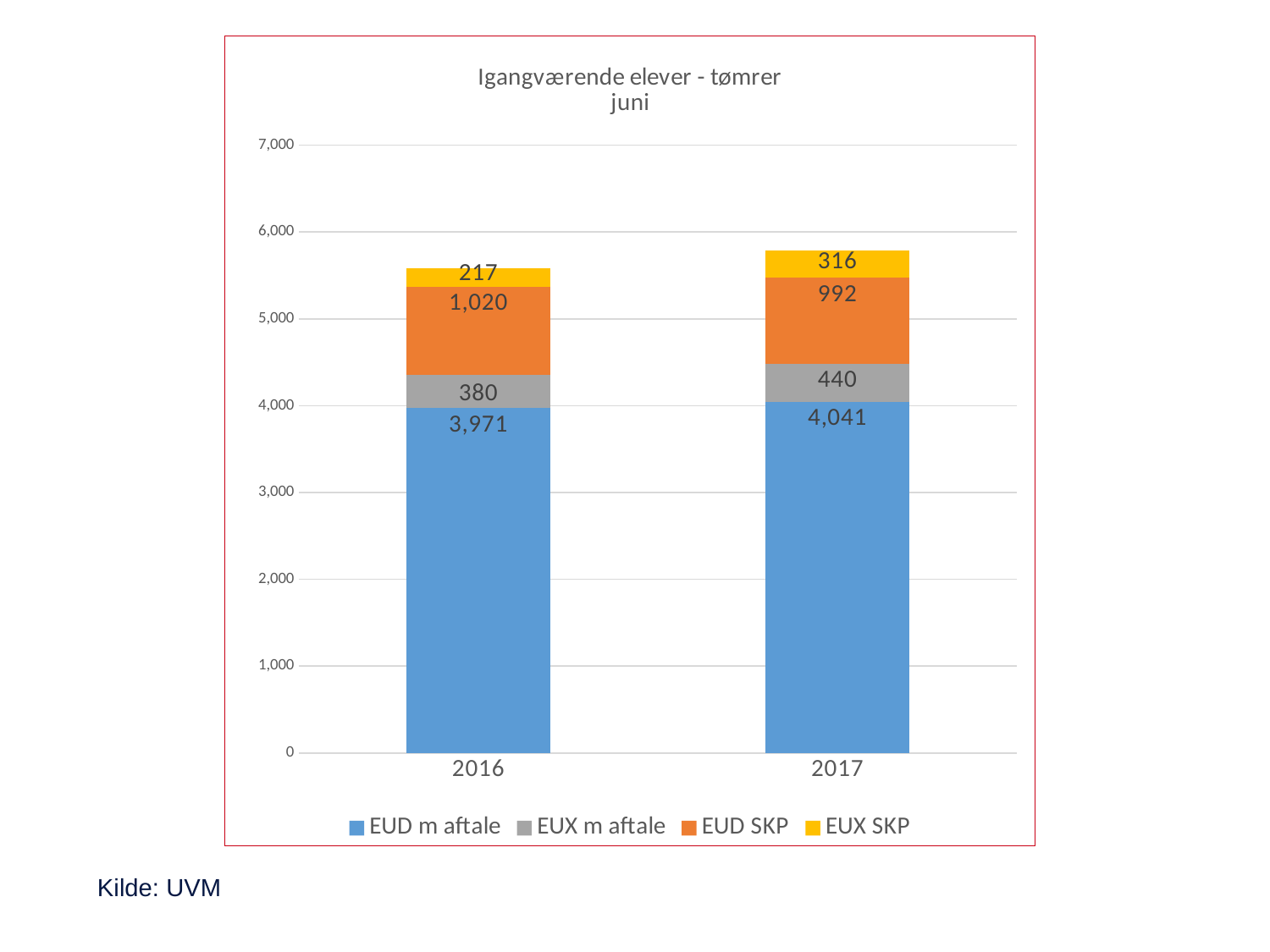
What is the difference between the EUX SKP values for 2017 and 2016? 99 What is the value for EUX SKP in 2017? 316 Which year has the larger EUD SKP value, 2016 or 2017? 2016 What is the title of the chart? Igangværende elever - tømrer juni What is the value for EUD m aftale in 2016? 3,971 What is the value for EUX m aftale in 2017? 440 What is the difference between the EUD m aftale values for 2017 and 2016? 70 What kind of chart is shown on the slide? Stacked bar chart What is the total of the stacked bar for 2017? 5,789 What is the value for EUD SKP in 2016? 1,020 How many series does the legend list? 4 What is the total of the stacked bar for 2016? 5,588